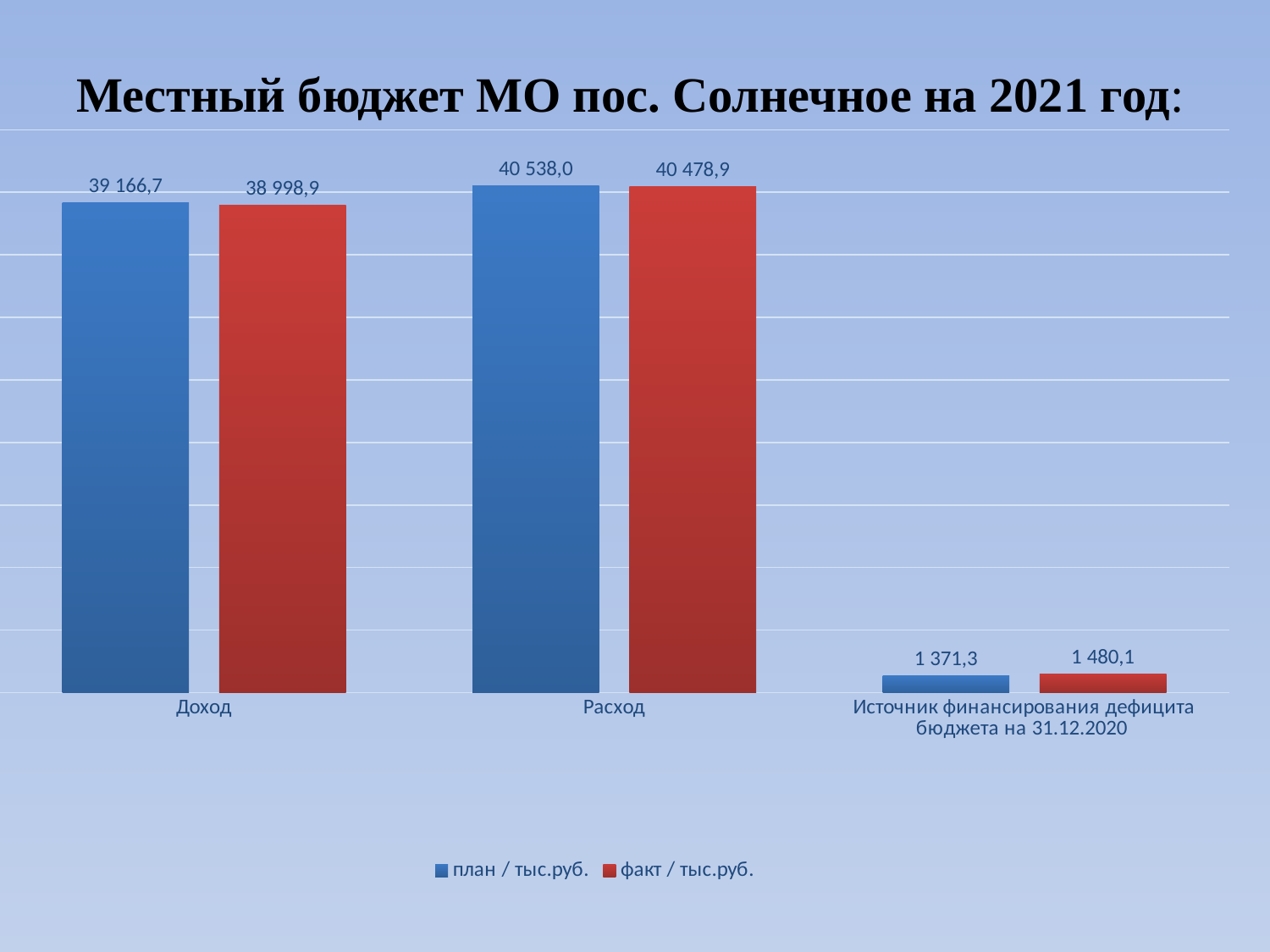
What is the difference between the план and факт values for Расход? 59,1 How many series does the legend list? 2 Which category has the lowest факт value? Источник финансирования дефицита бюджета на 31.12.2020 What is the план value for Доход? 39 166,7 What is the факт value for Источник финансирования дефицита бюджета на 31.12.2020? 1 480,1 How many categories are shown on the x axis? 3 What is the difference between the план and факт values for Доход? 167,8 What is the факт value for Расход? 40 478,9 What kind of chart is shown on the slide? bar chart What is the план value for Источник финансирования дефицита бюджета на 31.12.2020? 1 371,3 Which category has the highest план value? Расход For Доход, which is larger: план or факт? план